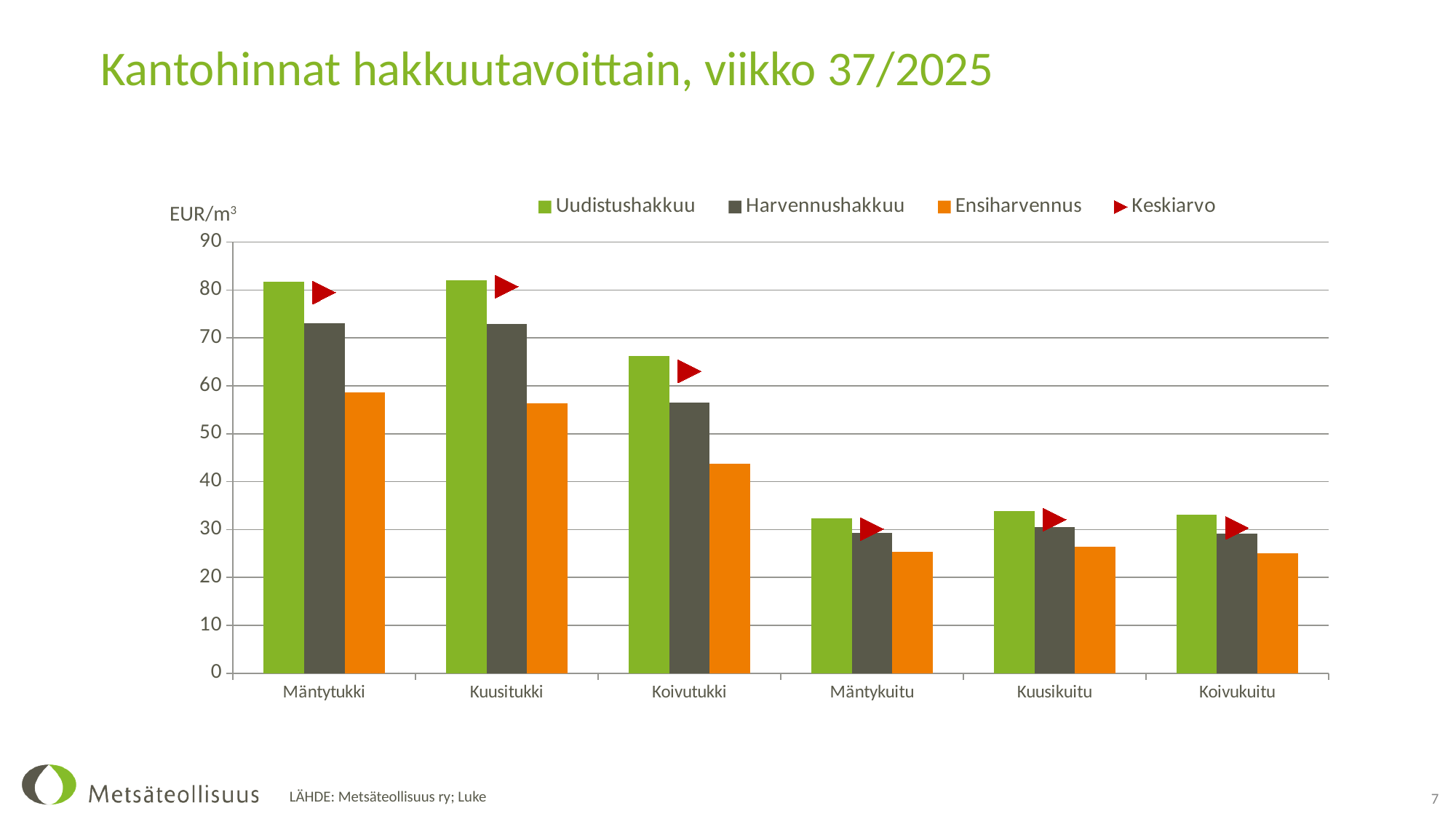
Is the Ensiharvennus value for Koivutukki greater or less than 50? less Is the Uudistushakkuu value for Kuusikuitu greater or less than 40? less How many series does the legend list? 4 Is the Ensiharvennus value for Mäntykuitu greater or less than 20? greater Which is larger, the Ensiharvennus value for Mäntytukki or for Koivutukki? Mäntytukki Which is larger, the Uudistushakkuu value for Koivutukki or for Mäntykuitu? Koivutukki What is the title of the chart? Kantohinnat hakkuutavoittain, viikko 37/2025 What unit is shown on the y axis? EUR/m³ How many categories are shown on the x axis? 6 What kind of chart is shown on the slide? bar chart